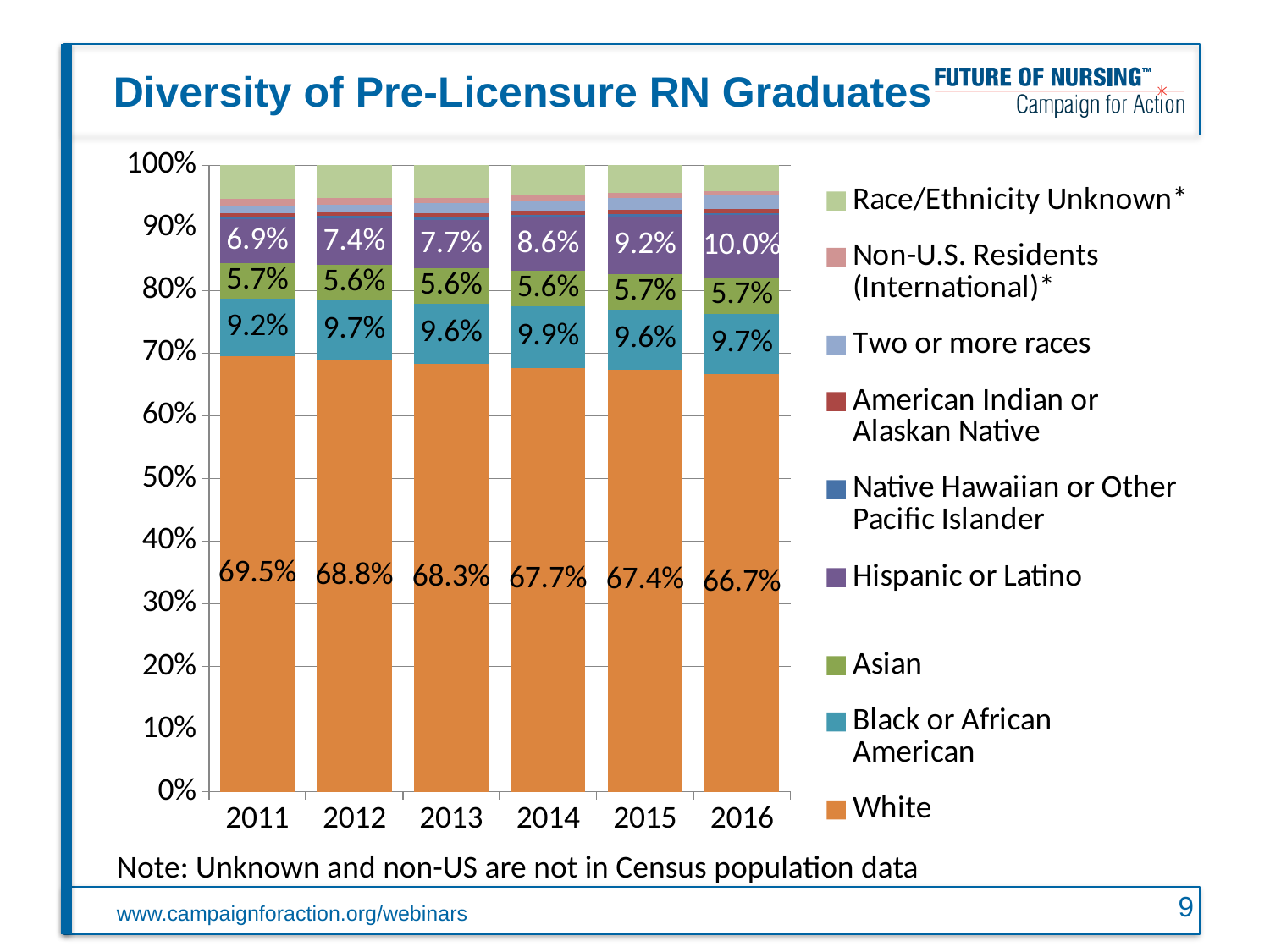
What is the value for Black or African American in 2011? 9.2% What is the value for White in 2016? 66.7% Does the White share rise or fall from 2011 to 2016? fall In which year is the White share lowest? 2016 In which year is the Hispanic or Latino share highest? 2016 Does the Hispanic or Latino share rise or fall from 2011 to 2016? rise How many years are shown on the x axis? 6 What is the difference between the White share in 2011 and in 2016? 2.8 percentage points How many series does the legend list? 9 Which year has the larger Black or African American share, 2012 or 2014? 2014 What kind of chart is shown on the slide? stacked bar chart What is the value for Hispanic or Latino in 2014? 8.6%